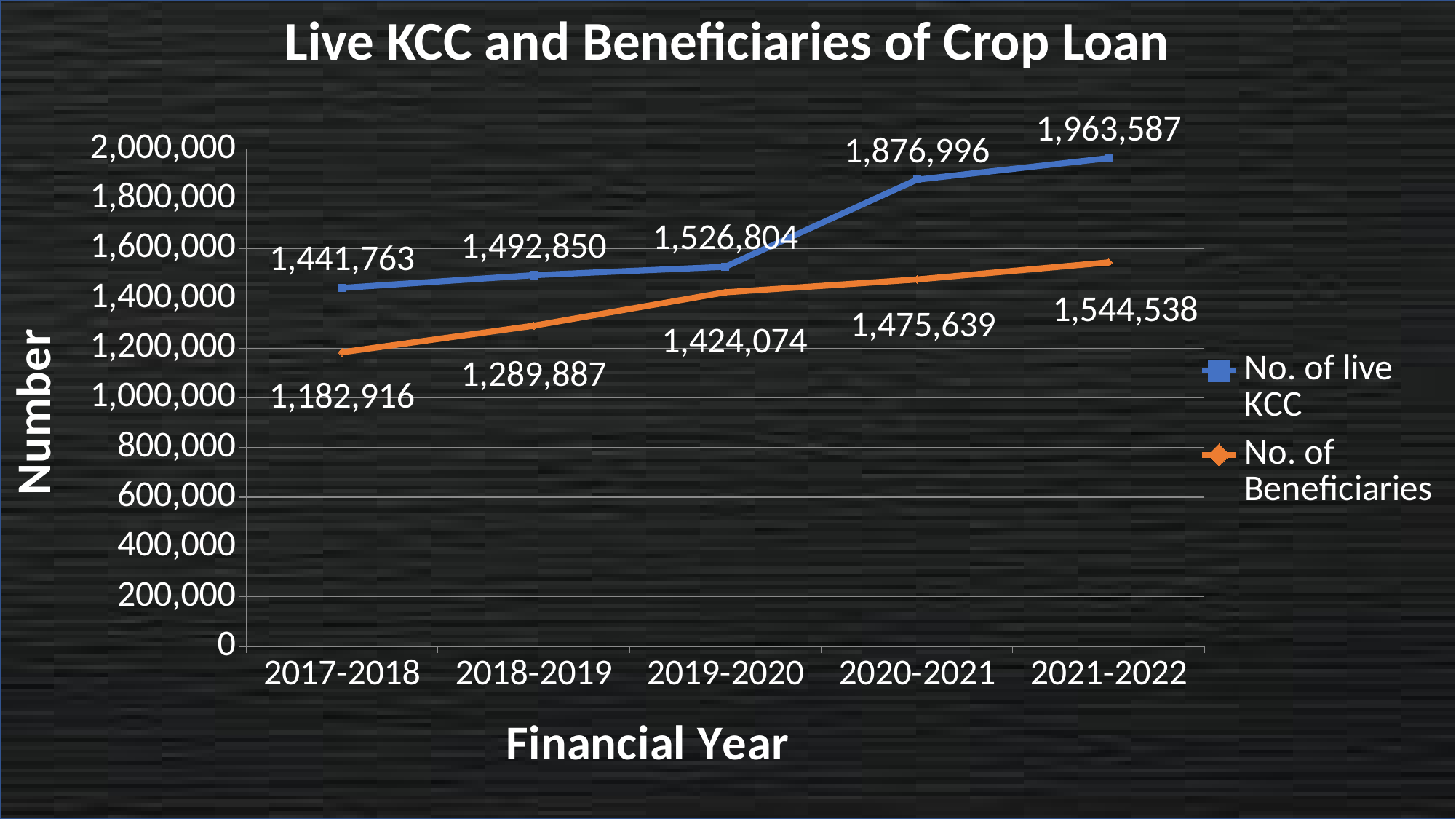
In which financial year is the number of live KCC highest? 2021-2022 What type of chart is shown on the slide? Line chart What is the number of live KCC in 2020-2021? 1,876,996 Does the number of beneficiaries rise or fall from 2017-2018 to 2021-2022? Rise Which is larger in 2018-2019: the number of live KCC or the number of beneficiaries? No. of live KCC How many financial years are shown on the x axis? 5 How many series does the legend list? 2 What is the number of beneficiaries in 2021-2022? 1,544,538 What is the difference between the number of live KCC and the number of beneficiaries in 2021-2022? 419,049 What is the number of live KCC in 2017-2018? 1,441,763 What is the number of beneficiaries in 2019-2020? 1,424,074 In which financial year is the number of beneficiaries lowest? 2017-2018